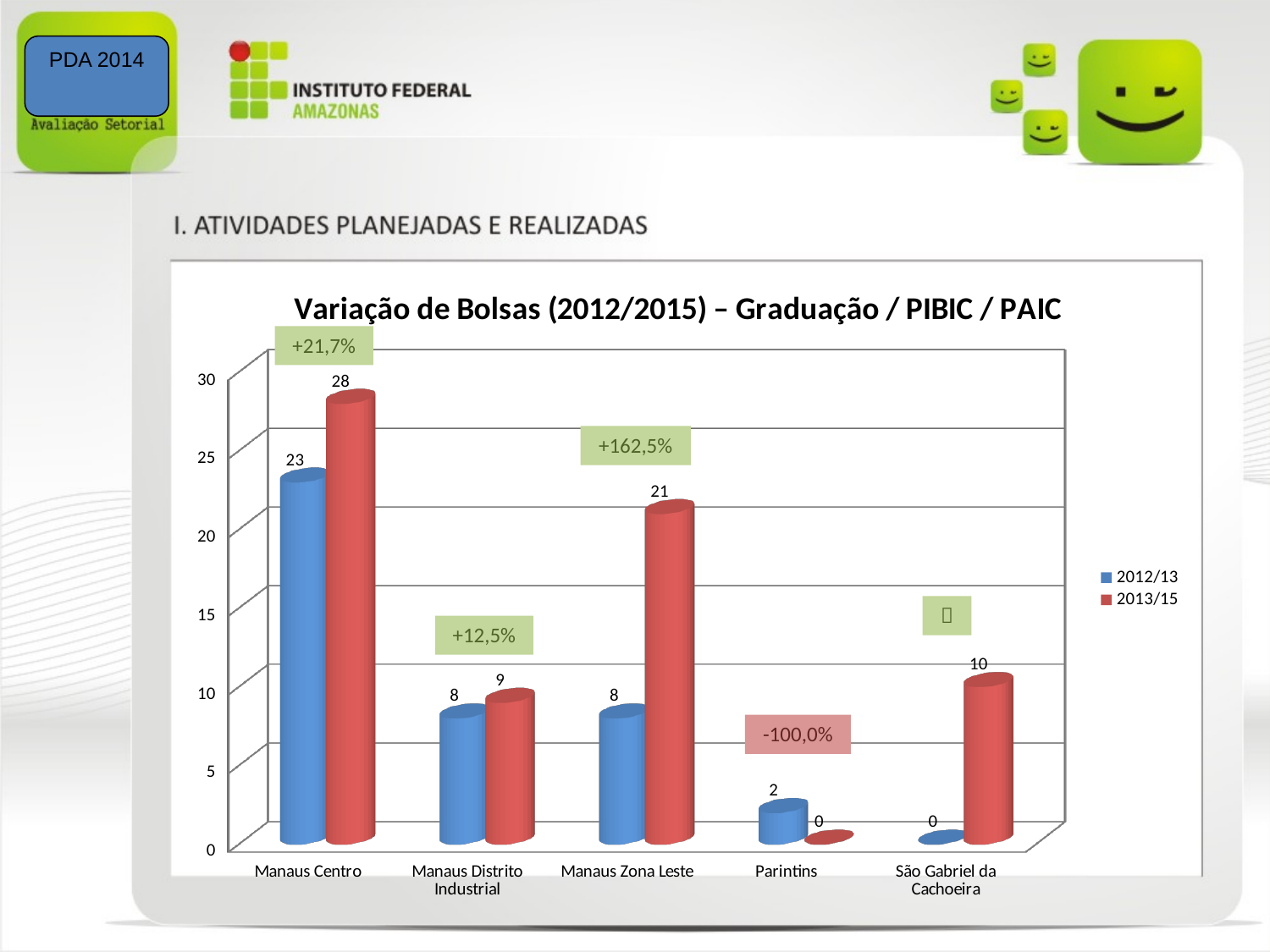
Which category has the lowest value in the 2012/13 series? São Gabriel da Cachoeira What is the value for Manaus Zona Leste in the 2012/13 series? 8 What percentage change is labelled above the Manaus Zona Leste bars? +162,5% What is the title of the chart? Variação de Bolsas (2012/2015) – Graduação / PIBIC / PAIC What is the value for São Gabriel da Cachoeira in the 2013/15 series? 10 What kind of chart is shown on the slide? Bar chart Which category has the highest value in the 2013/15 series? Manaus Centro What is the difference between the 2013/15 and 2012/13 values for Manaus Zona Leste? 13 Which is larger for Parintins: the 2012/13 value or the 2013/15 value? 2012/13 How many series does the legend list? 2 What is the value for Manaus Centro in the 2013/15 series? 28 How many categories are shown on the x axis? 5